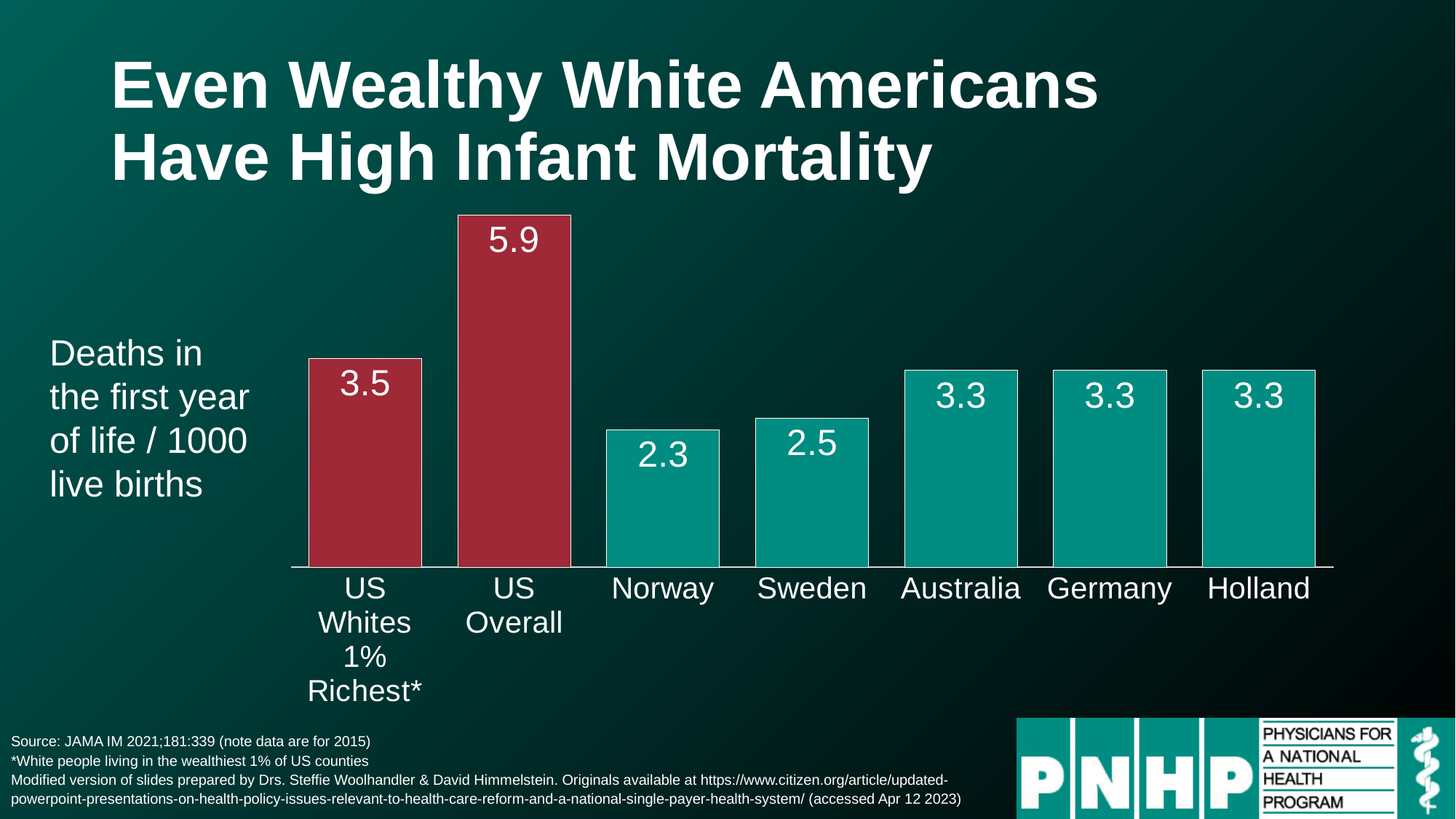
Which is larger, the value for US Whites 1% Richest* or the value for Germany? US Whites 1% Richest* What is the value for US Whites 1% Richest*? 3.5 How many categories are shown on the chart? 7 What unit does the chart's axis description say the values are measured in? Deaths in the first year of life / 1000 live births What is the infant mortality value for US Overall? 5.9 What is the value for Norway? 2.3 What kind of chart is shown on the slide? Bar chart What is the difference between the value for US Whites 1% Richest* and the value for Norway? 1.2 Which category has the lowest value? Norway What is the value for Sweden? 2.5 What is the difference between the US Overall value and the US Whites 1% Richest* value? 2.4 Which category has the highest value? US Overall